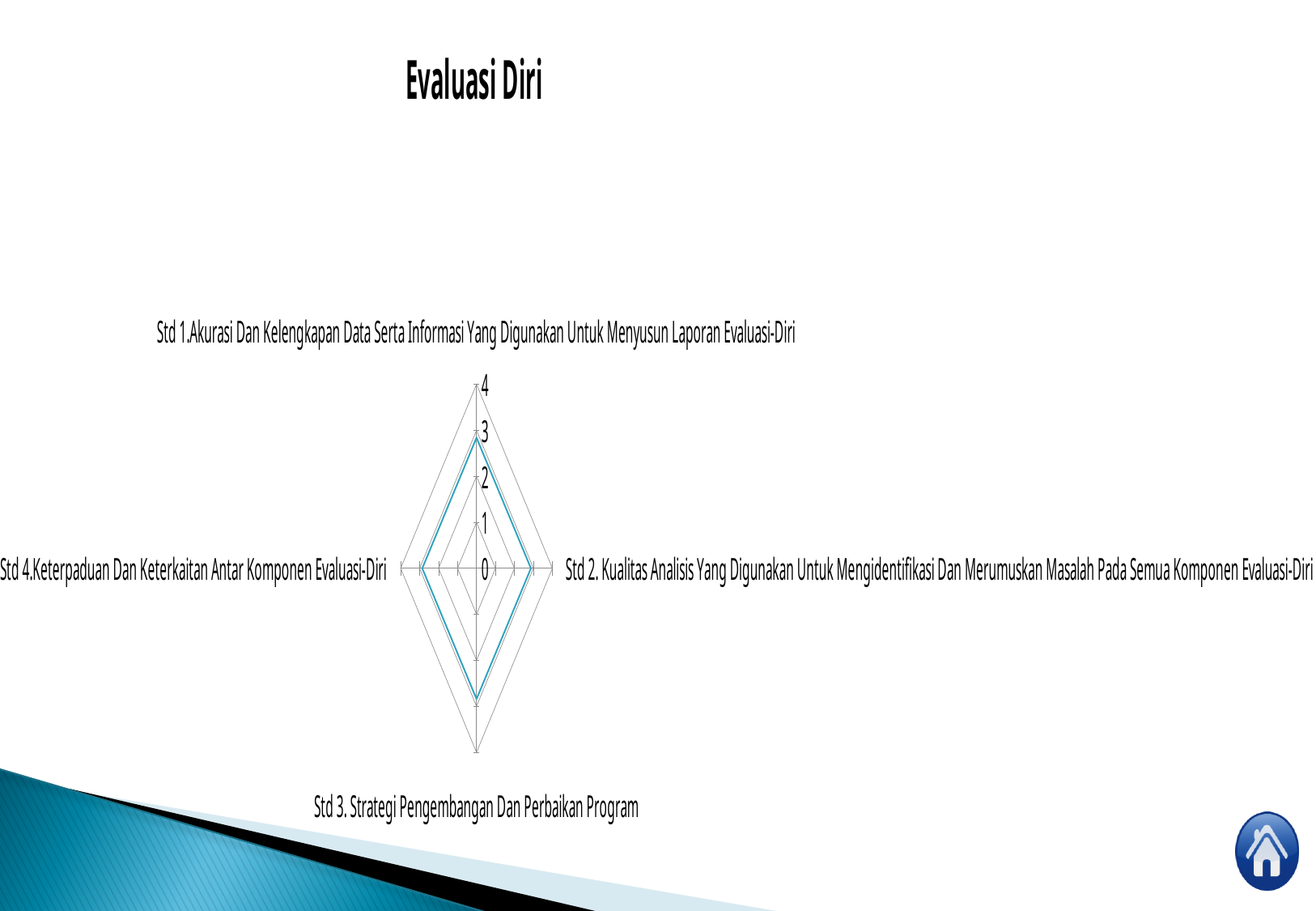
Is the value for Std 1 greater or less than 1? greater Is the value for Std 3 greater or less than 4? less What is the title of the slide containing the radar chart? Evaluasi Diri Is the value for Std 2 greater or less than 2? greater What kind of chart is shown on the slide? radar chart What is the highest value shown on the radar chart's axis scale? 4 How many categories (axes) does the radar chart have? 4